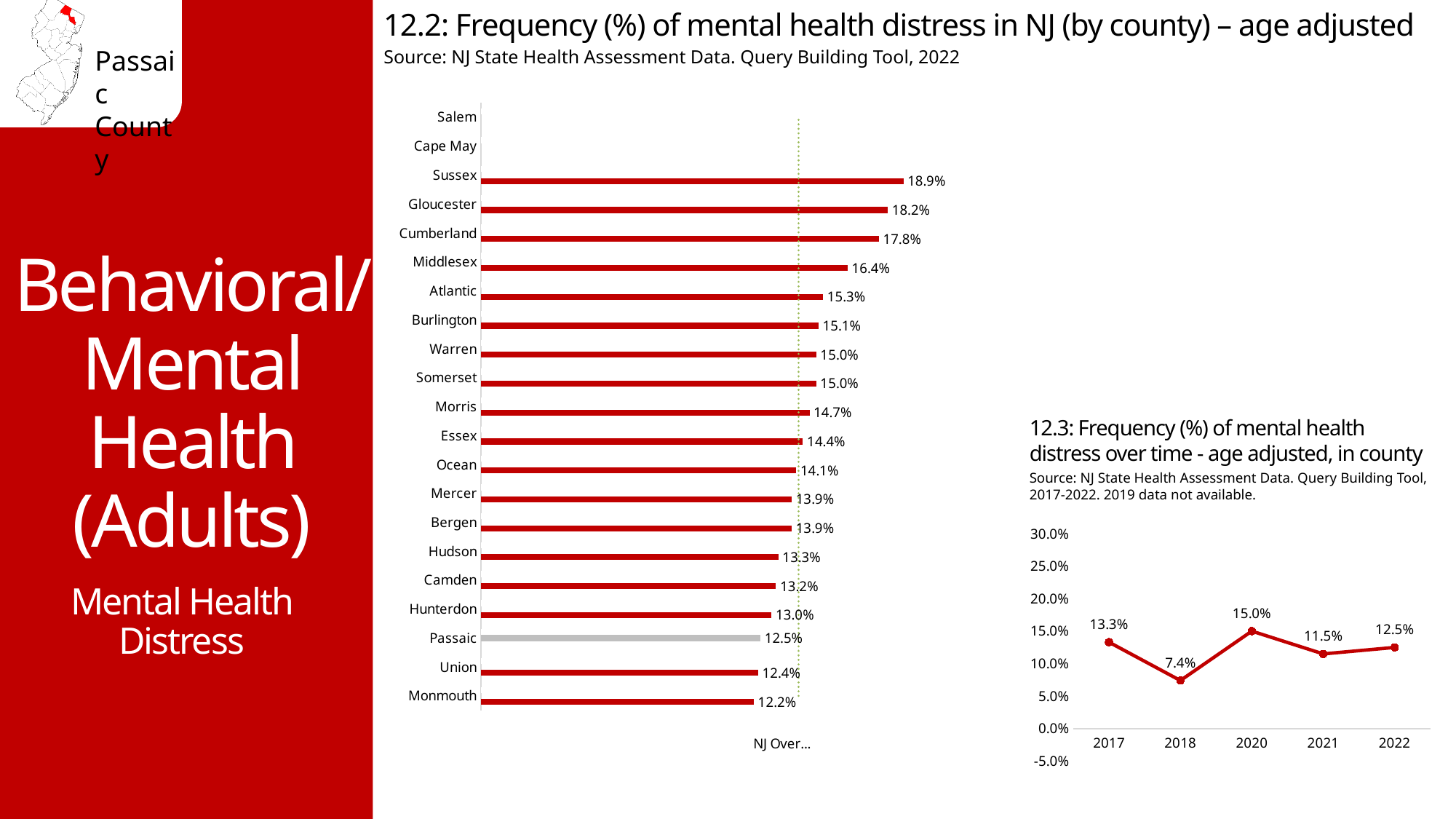
In chart 12.2, what is the difference between the values for Sussex and Passaic? 6.4% In chart 12.2, which county has the highest value? Sussex In chart 12.2, which county with a plotted bar has the lowest value? Monmouth In chart 12.2, which is larger, the value for Middlesex or the value for Atlantic? Middlesex In chart 12.3, what is the value for 2018? 7.4% In chart 12.2, what is the value for Passaic? 12.5% In chart 12.3, how many data points are plotted? 5 In chart 12.2, what is the value for Cumberland? 17.8% In chart 12.2, which county's bar is shown in grey instead of red? Passaic In chart 12.3, which year has the highest value? 2020 In chart 12.3, what is the difference between the values for 2020 and 2021? 3.5% What kind of chart is chart 12.2? bar chart